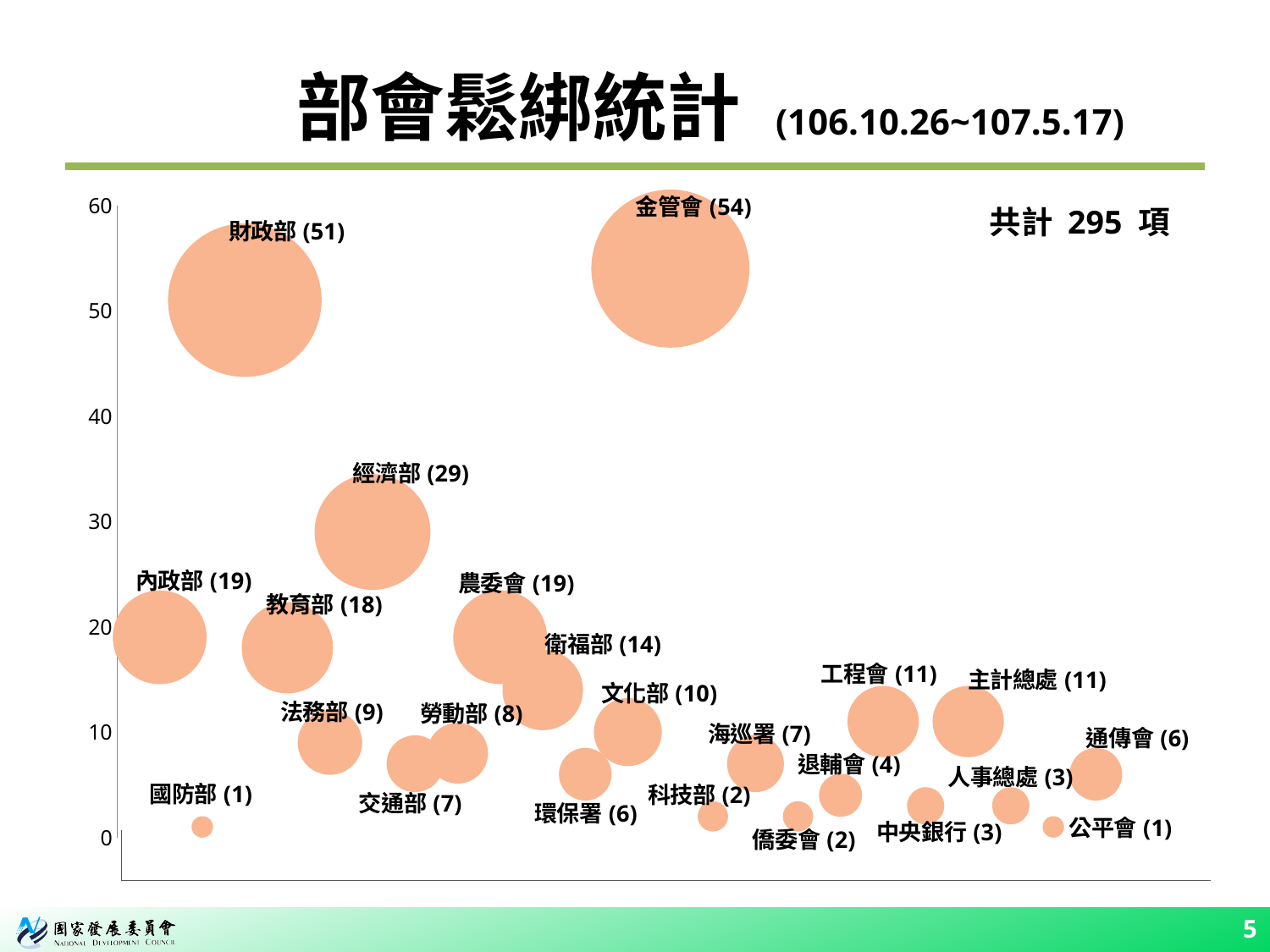
Which ministry has the highest value in the chart? 金管會 What is the value for 衛福部? 14 Which has a larger value, 內政部 or 教育部? 內政部 What is the difference between the values for 經濟部 and 教育部? 11 What kind of chart is shown on the slide? bubble chart How many ministries or agencies are plotted in the chart? 23 Is the value for 經濟部 greater or less than 20? greater What is the value for 經濟部? 29 What is the value for 財政部? 51 What total number of items (共計) is stated on the slide? 295 項 What is the value for 金管會? 54 What is the difference between the values for 金管會 and 財政部? 3